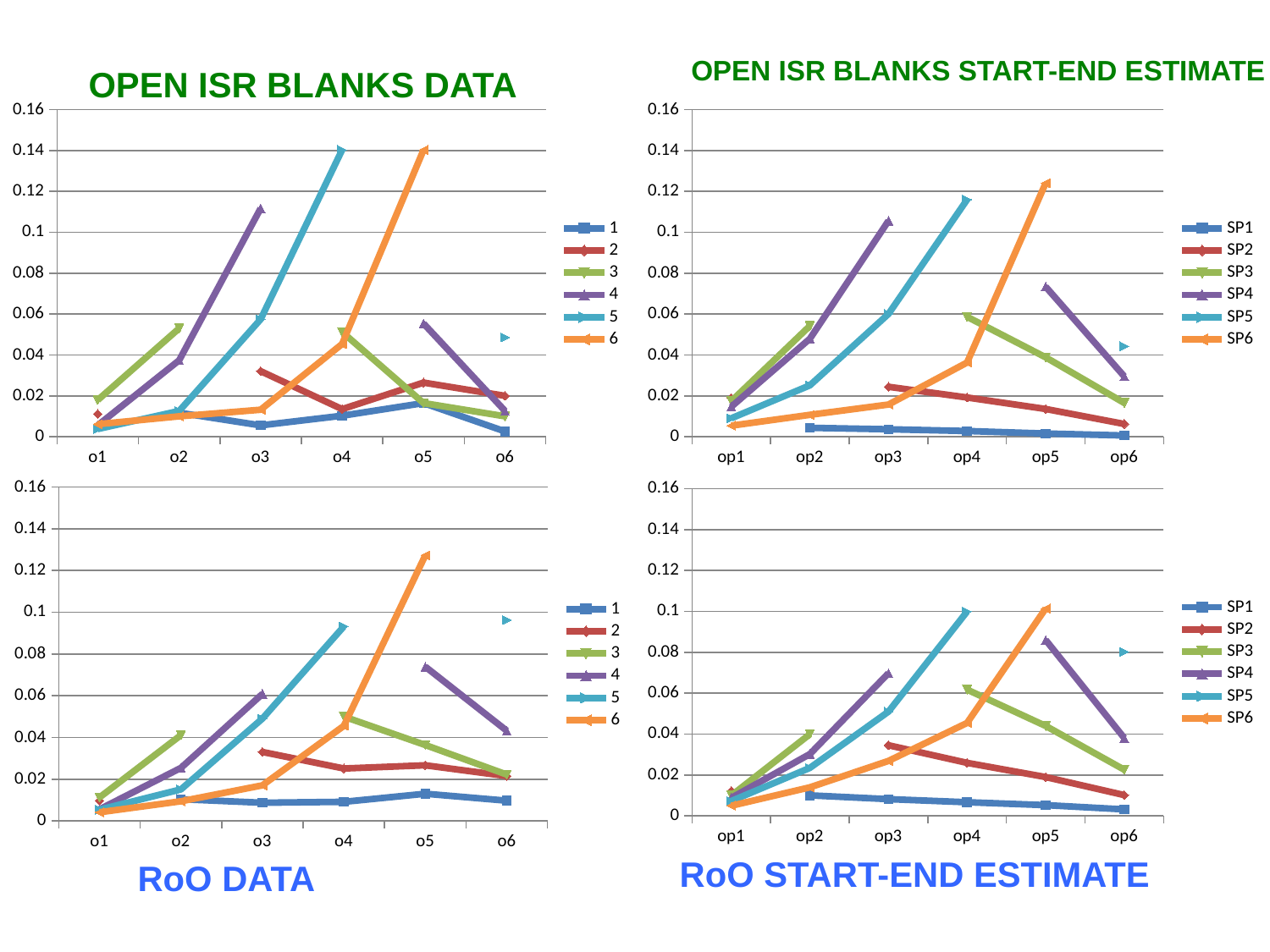
In the RoO DATA chart, at o5, which is higher: series 4 or series 3? series 4 How many series does the legend of the OPEN ISR BLANKS DATA chart list? 6 In the OPEN ISR BLANKS START-END ESTIMATE chart, does SP1 rise or fall from op2 to op6? fall In the RoO DATA chart, does series 6 rise or fall from o1 to o5? rise What kind of chart is the OPEN ISR BLANKS DATA chart? line chart In the OPEN ISR BLANKS START-END ESTIMATE chart, which series reaches the highest value? SP6 How many categories are on the x axis of the RoO DATA chart? 6 What are the legend entries of the RoO START-END ESTIMATE chart? SP1, SP2, SP3, SP4, SP5, SP6 In the RoO DATA chart, is the value for series 6 at o5 greater or less than 0.1? greater In the RoO START-END ESTIMATE chart, is the value for SP1 at op6 greater or less than 0.02? less In the OPEN ISR BLANKS DATA chart, which series has the lowest value at o6? 1 In the OPEN ISR BLANKS DATA chart, is the value for series 5 at o4 greater or less than 0.12? greater